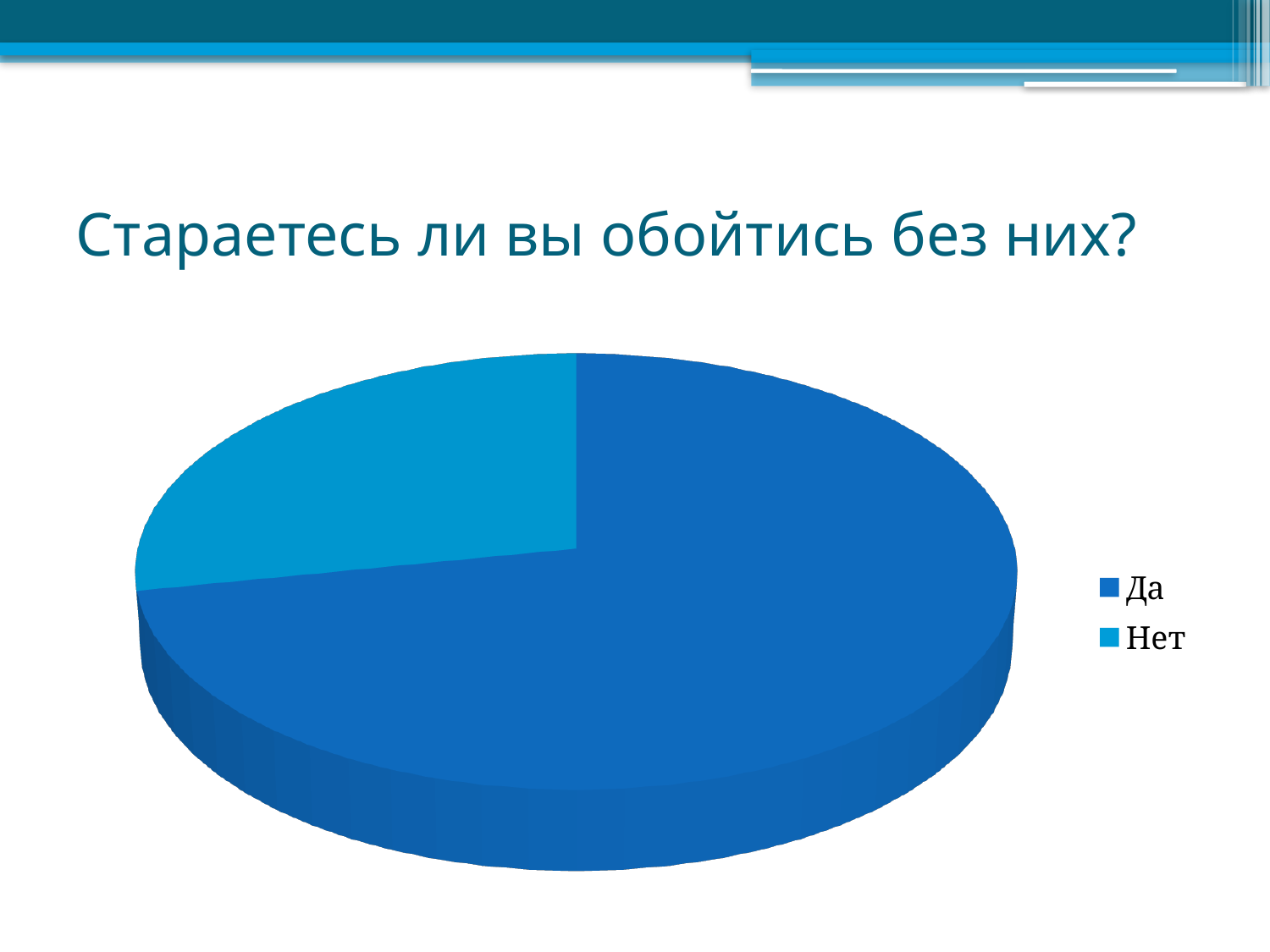
Which slice is larger, Да or Нет? Да What kind of chart is shown on the slide? pie chart Does the Да slice take up more or less than half of the pie? more Which category has the largest slice of the pie? Да What are the two legend entries of the chart? Да, Нет How many entries does the legend list? 2 Which category has the smallest slice of the pie? Нет What is the title of the slide above the chart? Стараетесь ли вы обойтись без них? How many slices does the pie chart have? 2